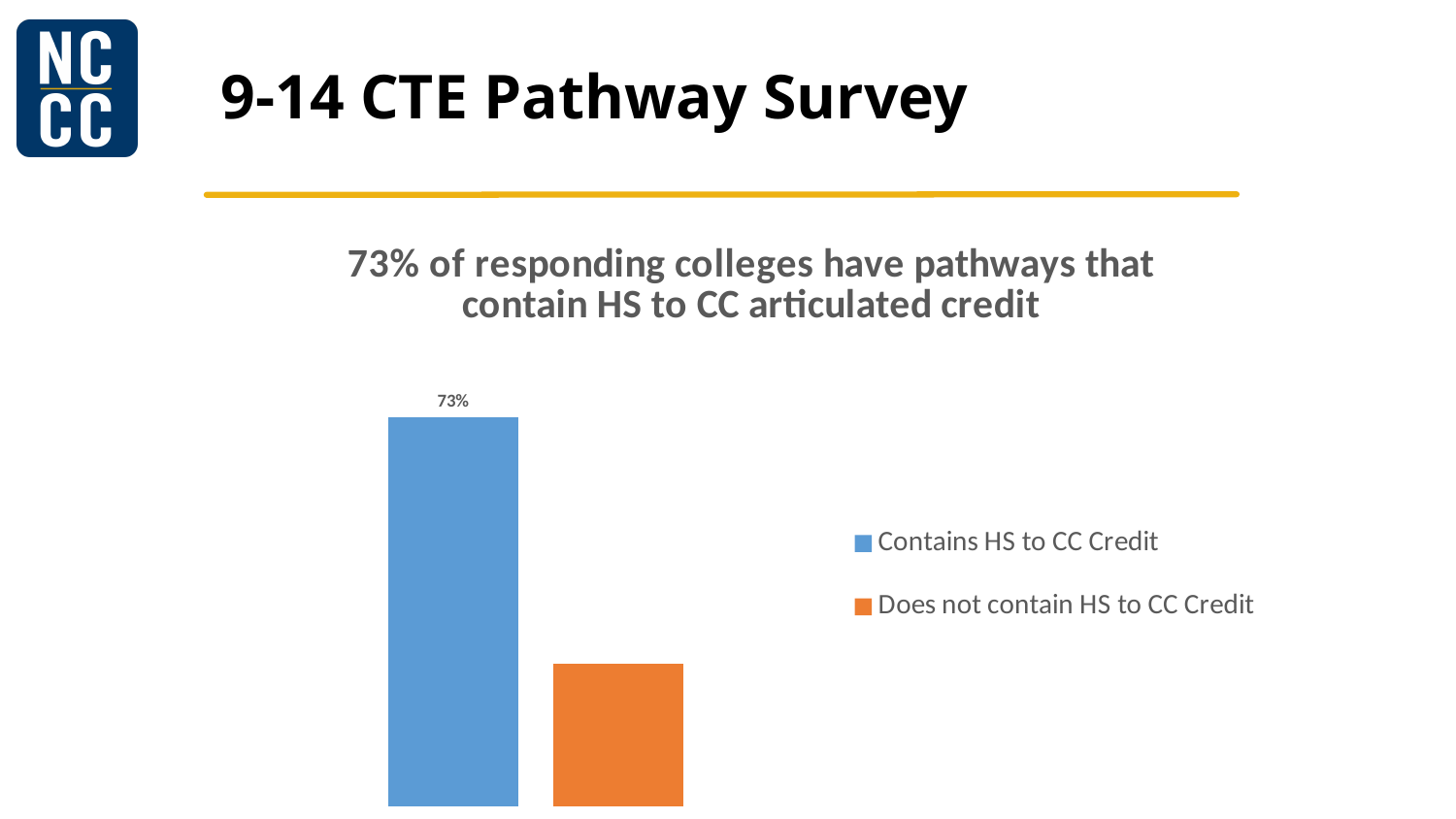
What colour is the bar for 'Does not contain HS to CC Credit'? Orange How many bars are plotted in the chart? 2 Which category has the shortest bar in the chart? Does not contain HS to CC Credit What is the title of the chart on the slide? 73% of responding colleges have pathways that contain HS to CC articulated credit Which bar is taller: 'Contains HS to CC Credit' or 'Does not contain HS to CC Credit'? Contains HS to CC Credit Which category has the tallest bar in the chart? Contains HS to CC Credit What kind of chart is shown on the slide? Bar chart What percentage of responding colleges have pathways that contain HS to CC credit, according to the data label on the chart? 73% How many entries does the chart legend list? 2 What colour is the bar for 'Contains HS to CC Credit'? Blue